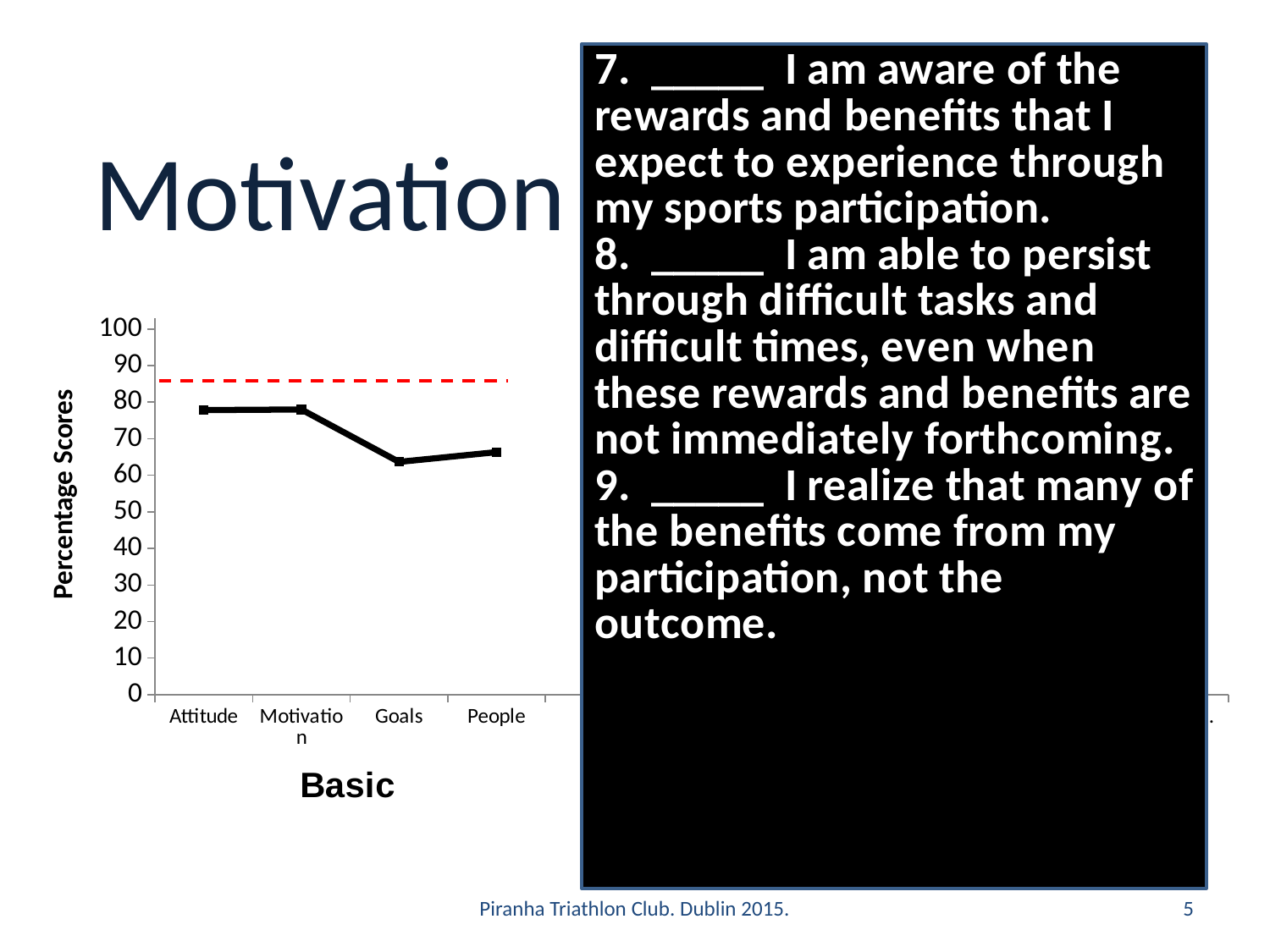
Is the value for Attitude greater or less than 70? greater What kind of chart is shown on the slide? line chart Which is larger, the value for Motivation or the value for People? Motivation What is the title of the vertical axis of the chart? Percentage Scores What label appears below the category axis of the chart? Basic Is the value for People greater or less than 70? less Is the value for Goals greater or less than 60? greater Among Attitude, Motivation, Goals and People, which category has the lowest value? Goals Which is larger, the value for Attitude or the value for Goals? Attitude